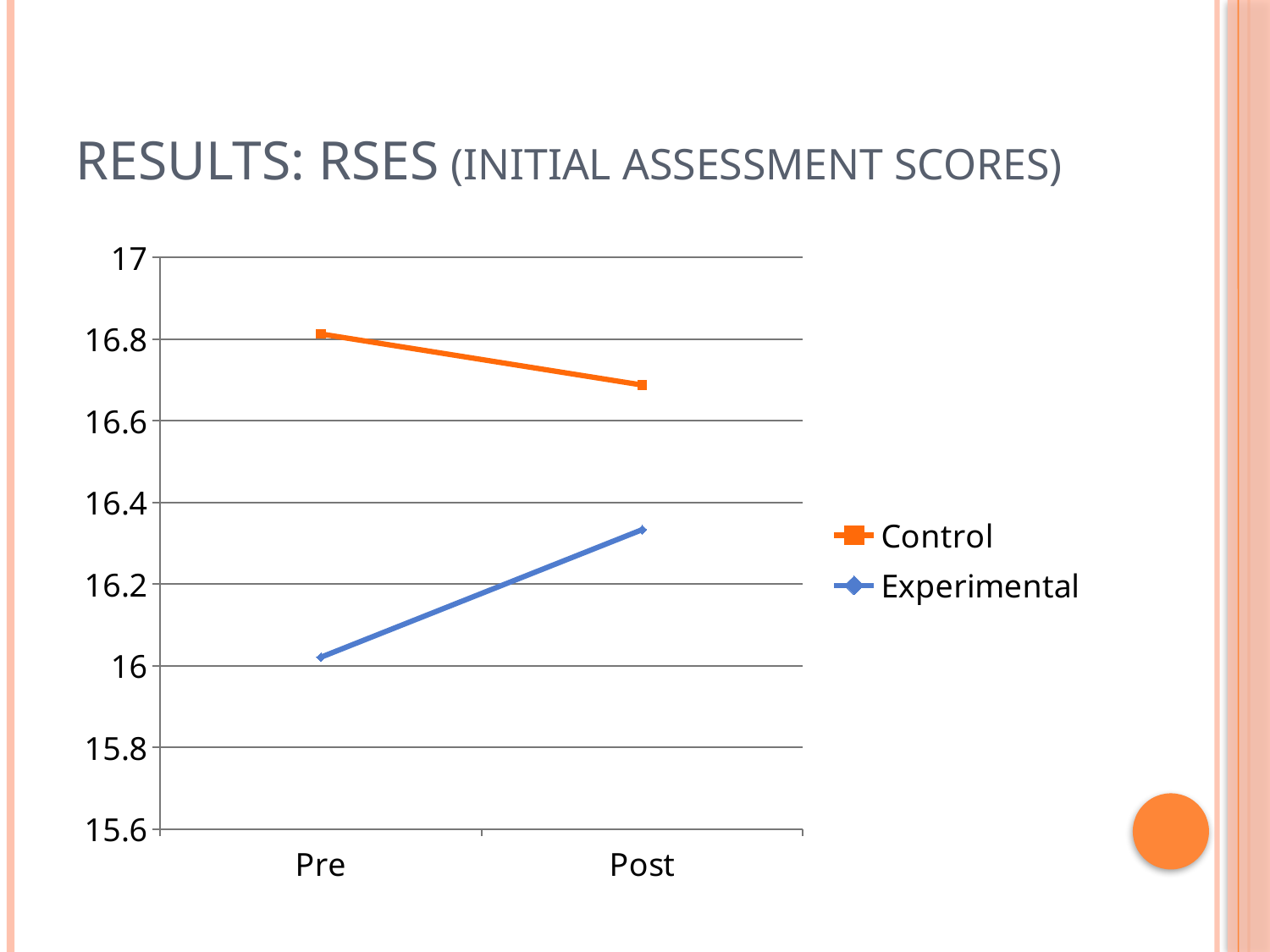
How many categories are shown on the x axis? 2 Does the Experimental series rise or fall from Pre to Post? rise What kind of chart is shown on the slide? line chart At Pre, which series has the higher value, Control or Experimental? Control Is the Experimental value at Post greater or less than 16.4? less Which series is drawn in orange? Control How many series does the legend list? 2 Is the Control value at Post greater or less than 16.6? greater At Post, which series has the higher value, Control or Experimental? Control Is the Experimental value at Pre greater or less than 16.2? less Does the Control series rise or fall from Pre to Post? fall